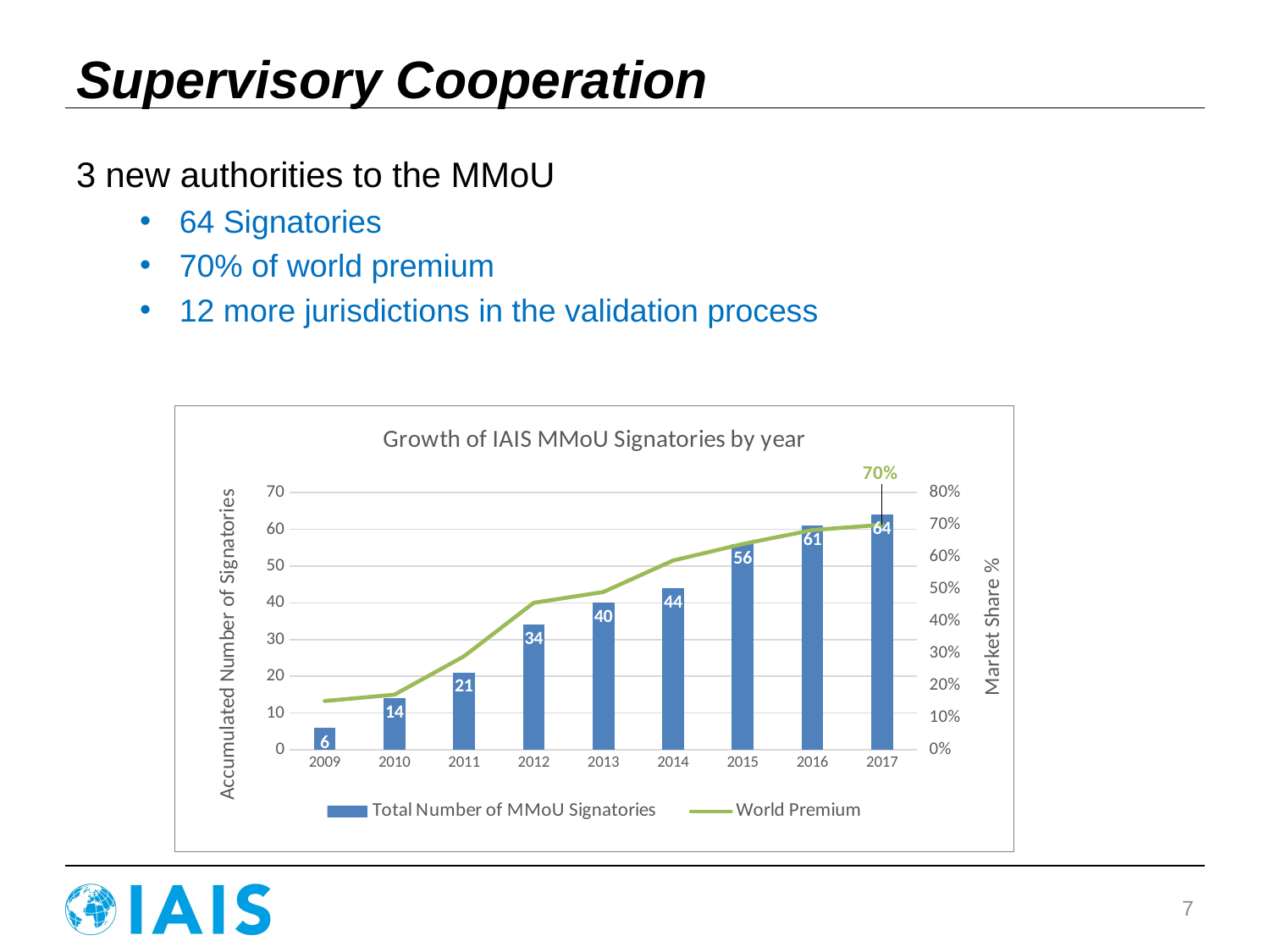
Which year has more MMoU signatories, 2013 or 2014? 2014 Which year has the highest total number of MMoU signatories? 2017 What is the total number of MMoU signatories in 2012? 34 What is the title of the chart? Growth of IAIS MMoU Signatories by year How many years are shown on the x axis of the chart? 9 Is the World Premium market share in 2012 greater or less than 30%? greater What is the World Premium market share in 2017? 70% Which year has the lowest total number of MMoU signatories? 2009 Does the total number of MMoU signatories rise or fall from 2009 to 2017? rise What is the total number of MMoU signatories in 2015? 56 How many series does the chart legend list? 2 What is the difference in the total number of MMoU signatories between 2017 and 2009? 58